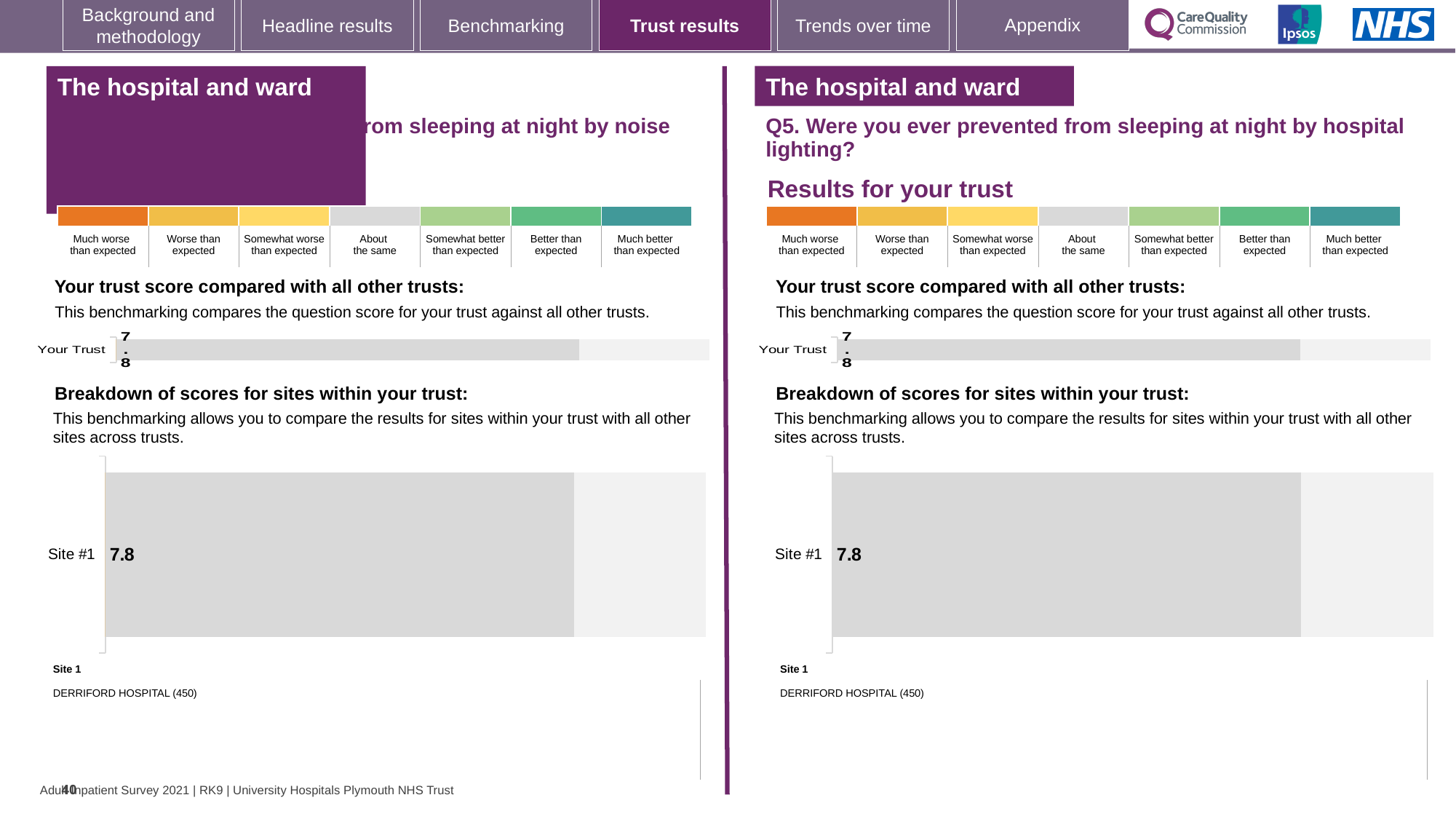
On the left half of the slide (sleeping at night by noise), what score is shown for Site #1? 7.8 On the right half of the slide (Q5), what is the difference between the Your Trust score and the Site #1 score? 0 What kind of chart is used for the breakdown of scores for sites on the right half of the slide? bar chart How many sites are shown in the breakdown of scores for sites chart on the right half of the slide? 1 On the right half of the slide (Q5, hospital lighting), what score is shown for Site #1 in the breakdown of scores for sites? 7.8 How many categories does the colour scale above the Q5 chart on the right half of the slide show, from 'Much worse than expected' to 'Much better than expected'? 7 On the left half of the slide, what is the difference between the Site #1 score and the Your Trust score? 0 On the right half of the slide (Q5, hospital lighting), what is the score shown for Your Trust? 7.8 On the right half of the slide, which hospital is listed as Site 1 below the site breakdown chart? DERRIFORD HOSPITAL (450) On the left half of the slide (sleeping at night by noise), what is the score shown for Your Trust? 7.8 How many bars are plotted in the 'Your trust score compared with all other trusts' chart on the left half of the slide? 1